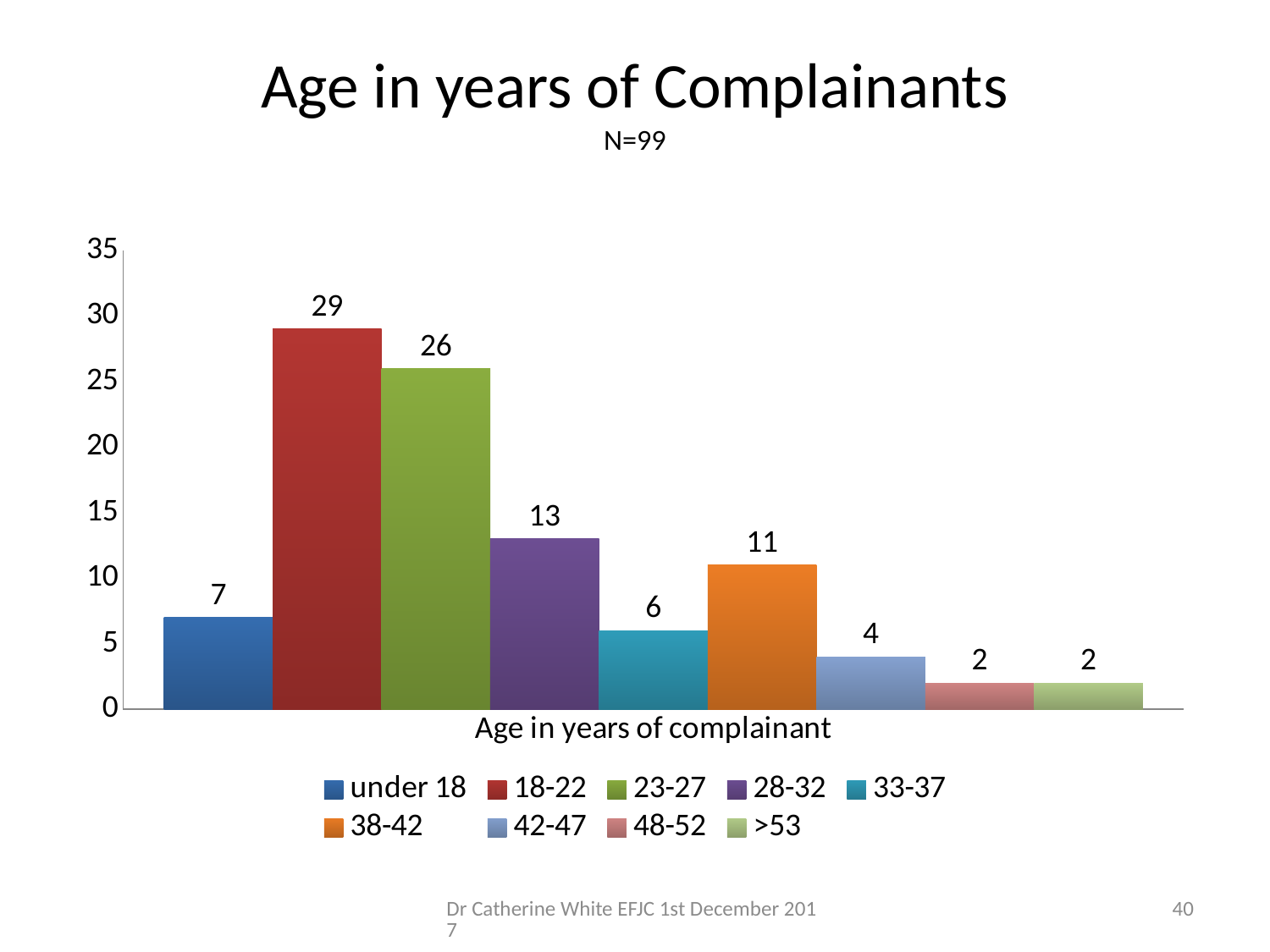
What kind of chart is shown on the slide? bar chart How many entries does the legend list? 9 Which age group has the highest value? 18-22 What is the difference between the values for 38-42 and 33-37? 5 Is the value for 23-27 greater or less than 25? greater How many age groups are shown in the chart? 9 What is the value for the 18-22 age group? 29 What is the difference between the values for 18-22 and 23-27? 3 What is the value for the 28-32 age group? 13 Which is larger, the value for 28-32 or the value for 38-42? 28-32 What is the value for the under 18 age group? 7 What is the title of the chart? Age in years of Complainants